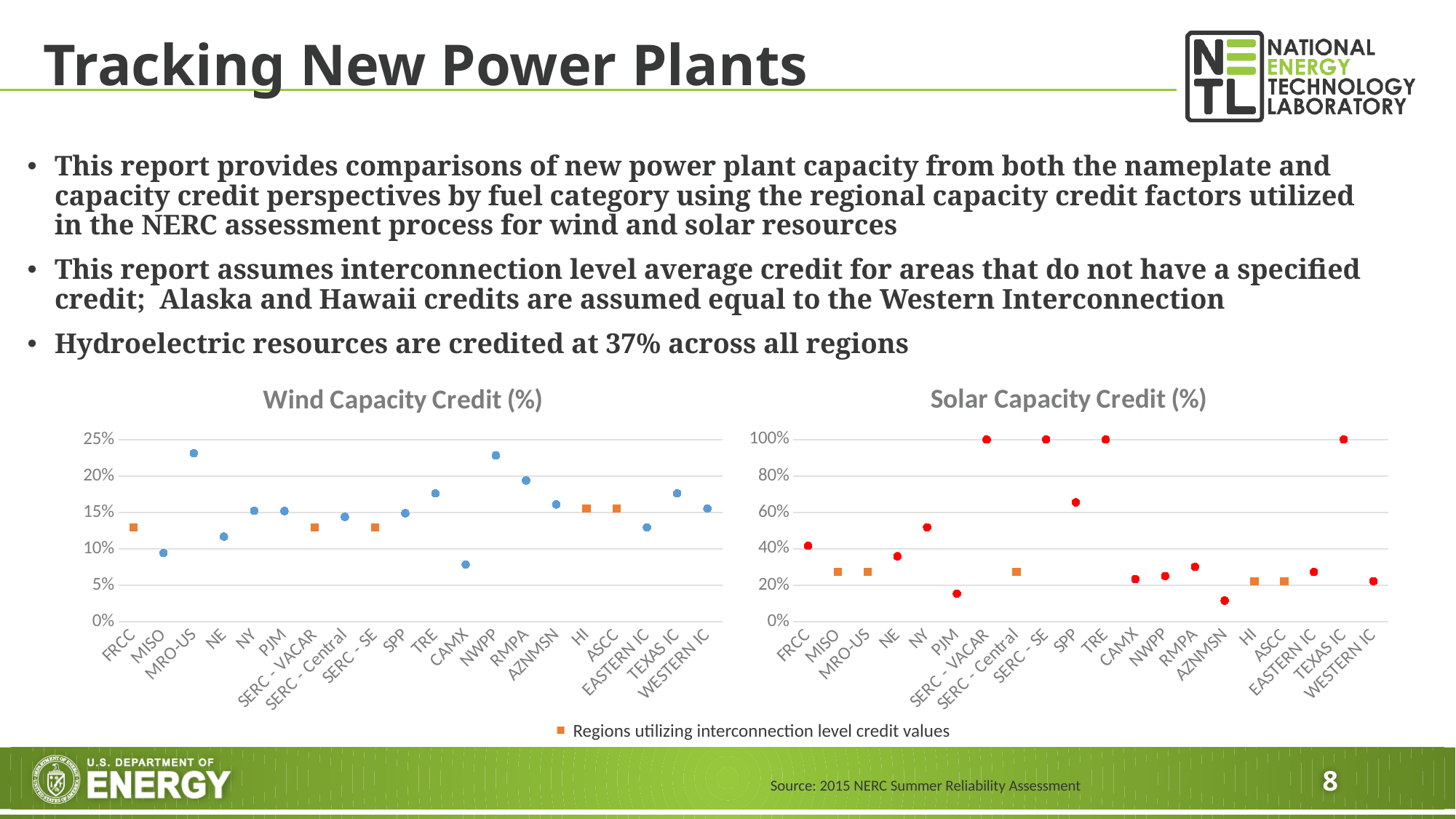
In the Wind Capacity Credit (%) chart, which is larger, the value for NWPP or the value for RMPA? NWPP In the Solar Capacity Credit (%) chart, which region has the lowest value? AZNMSN In the Solar Capacity Credit (%) chart, what is the value for TRE? 100% In the Wind Capacity Credit (%) chart, which region has the lowest value? CAMX In the Wind Capacity Credit (%) chart, is the value for MRO-US greater or less than 20%? greater In the Solar Capacity Credit (%) chart, is the value for PJM greater or less than 20%? less What does the orange square marker in the legend below the charts represent? Regions utilizing interconnection level credit values In the Wind Capacity Credit (%) chart, is the value for CAMX greater or less than 10%? less What kind of chart is the Wind Capacity Credit (%) chart? scatter chart How many regions are plotted on the x axis of the Solar Capacity Credit (%) chart? 20 In the Solar Capacity Credit (%) chart, what is the value for SERC - SE? 100%